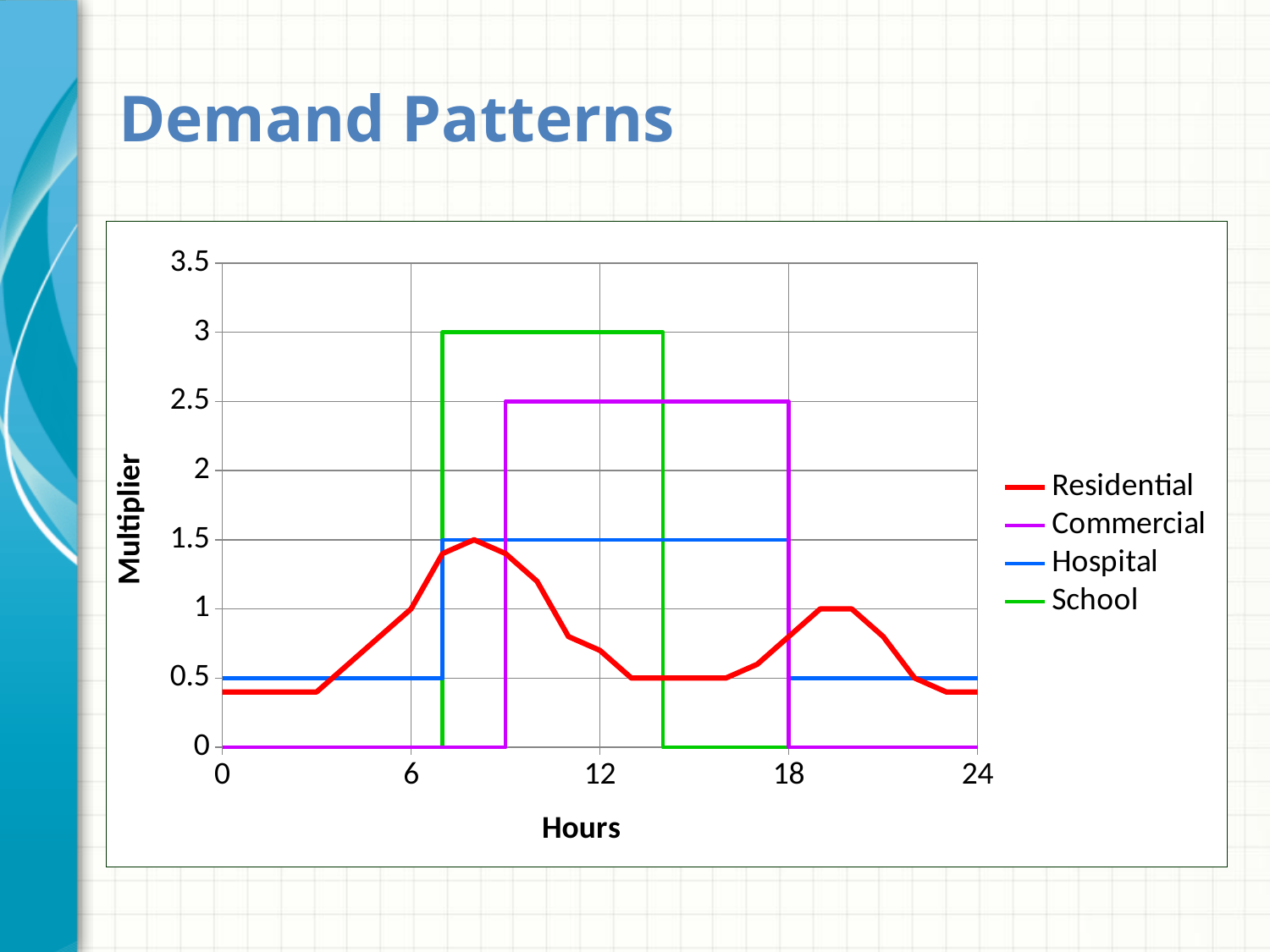
How many series does the legend list? 4 What is the difference between the peak multiplier of School and the peak multiplier of Commercial? 0.5 At hour 12, which is larger: the Commercial multiplier or the Residential multiplier? Commercial What kind of chart is shown on the slide? line chart Which series reaches the highest multiplier? School What is the Commercial multiplier value at hour 0? 0 What is the highest multiplier value reached by the Hospital series? 1.5 Does the Residential multiplier rise or fall between hour 8 and hour 13? fall What is the peak multiplier value for the Commercial series? 2.5 What is the peak multiplier value for the School series? 3 What is the title of the vertical axis? Multiplier Is the Residential multiplier at hour 0 greater or less than 0.5? less